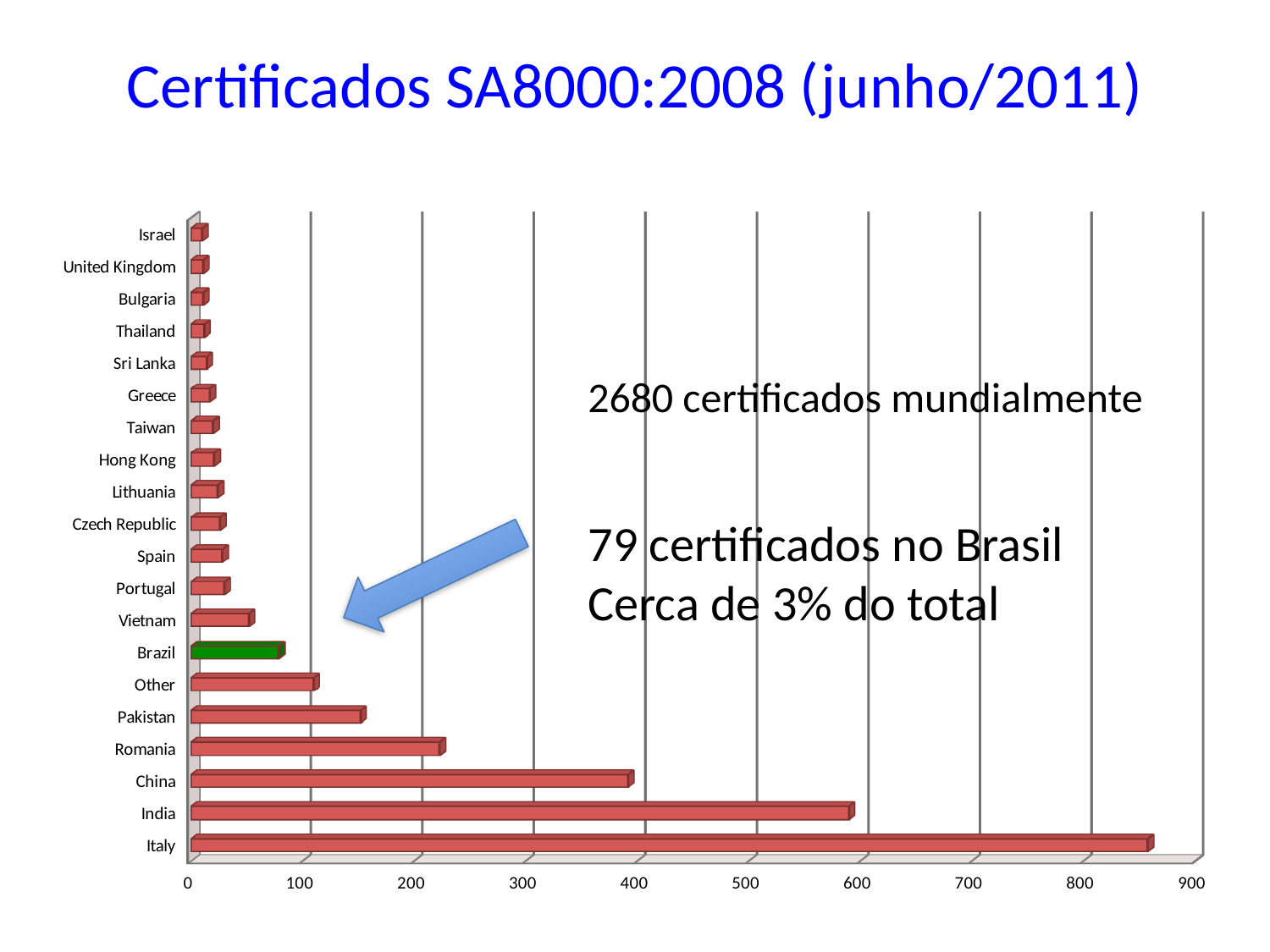
Is the value for Italy greater or less than 800? greater Which has more certificates, Pakistan or Romania? Romania How many categories (bars) are shown in the chart? 20 Which country has the highest number of SA8000 certificates in the chart? Italy Is the value for Romania greater or less than 200? greater Which has more certificates, India or China? India Which country's bar is coloured green in the chart? Brazil Is the value for China greater or less than 300? greater What kind of chart is shown on the slide? bar chart How many certificates does Brazil have according to the slide? 79